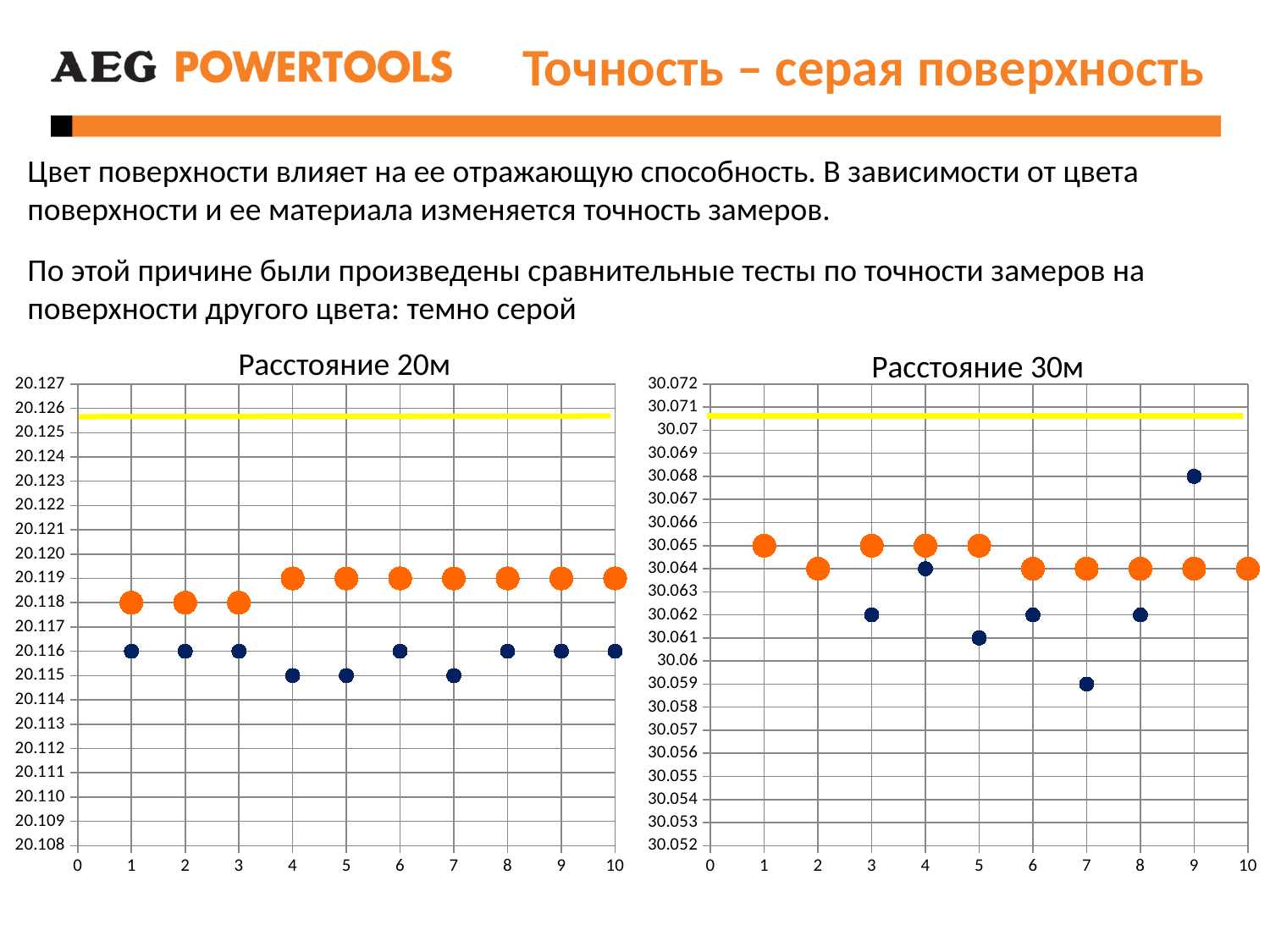
In the "Расстояние 30м" chart, at which x value is the blue point lowest? 7 In the "Расстояние 20м" chart, what is the difference between the orange and blue points at x = 10? 0.003 In the "Расстояние 20м" chart, do the orange points rise or fall from x = 1 to x = 10? rise In the "Расстояние 30м" chart, what is the value of the orange point at x = 1? 30.065 In the "Расстояние 20м" chart, which is larger at x = 4, the orange point or the blue point? the orange point In the "Расстояние 30м" chart, is the yellow line greater or less than 30.07? greater In the "Расстояние 30м" chart, at which x value is the blue point highest? 9 In the "Расстояние 20м" chart, what is the value of the orange point at x = 1? 20.118 In the "Расстояние 20м" chart, what is the value of the blue point at x = 4? 20.115 What kind of chart is the "Расстояние 20м" chart? scatter chart In the "Расстояние 20м" chart, what is the value of the orange point at x = 10? 20.119 How many charts are on the slide? 2